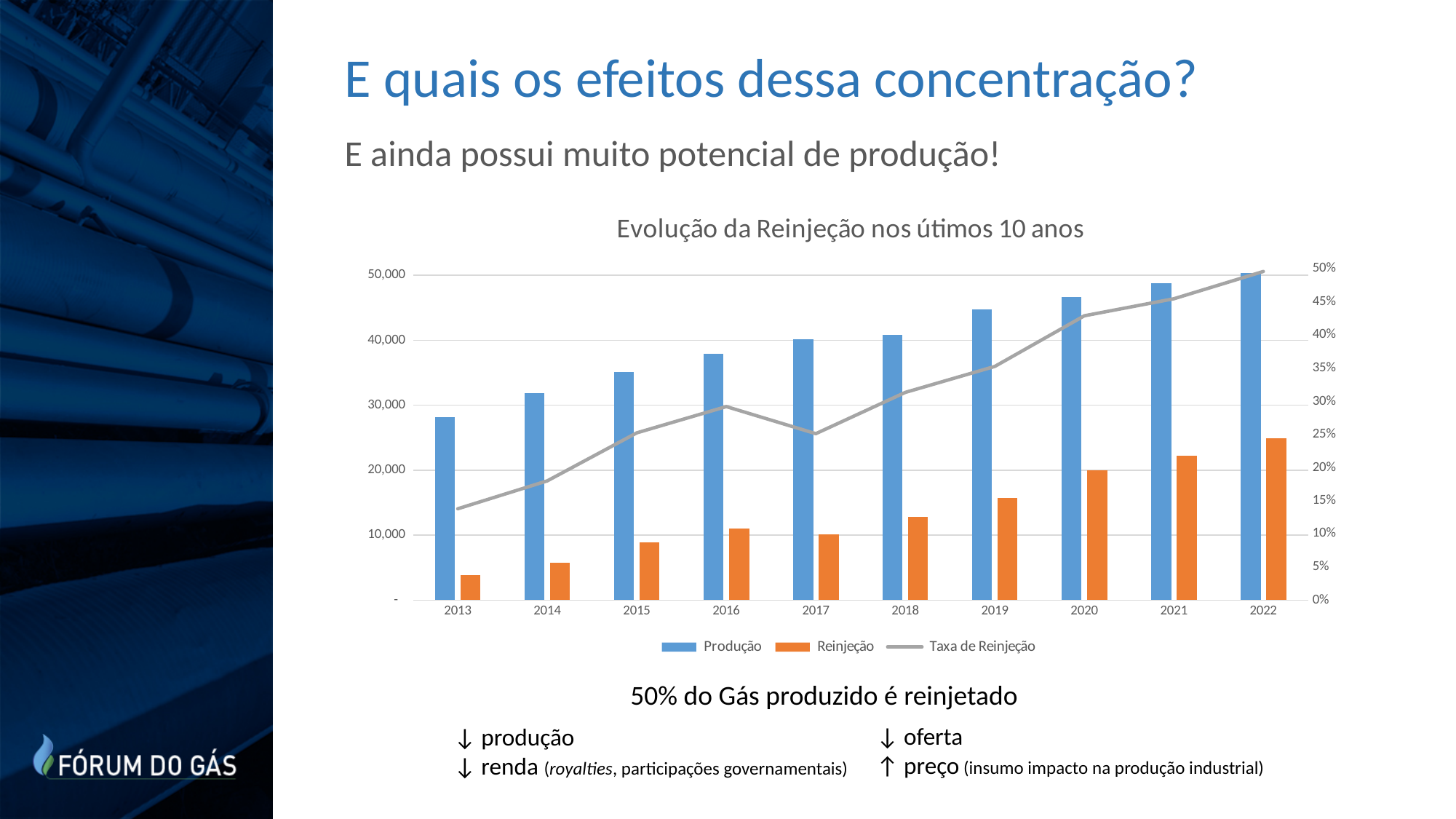
How many years are shown on the x axis of the chart? 10 Is the Produção value for 2013 greater or less than 30,000? less Is the Reinjeção value for 2022 greater or less than 20,000? greater Which series is drawn as a gray line in the chart? Taxa de Reinjeção What is the title of the chart? Evolução da Reinjeção nos útimos 10 anos What kind of chart is shown on the slide? Bar chart with a line How many series does the chart legend list? 3 Do the Produção bars rise or fall from 2013 to 2022? Rise Which is larger, the Reinjeção value for 2020 or for 2015? 2020 Is the Taxa de Reinjeção for 2013 greater or less than 20%? less In which year is the Produção bar the highest? 2022 In which year is the Reinjeção bar the lowest? 2013